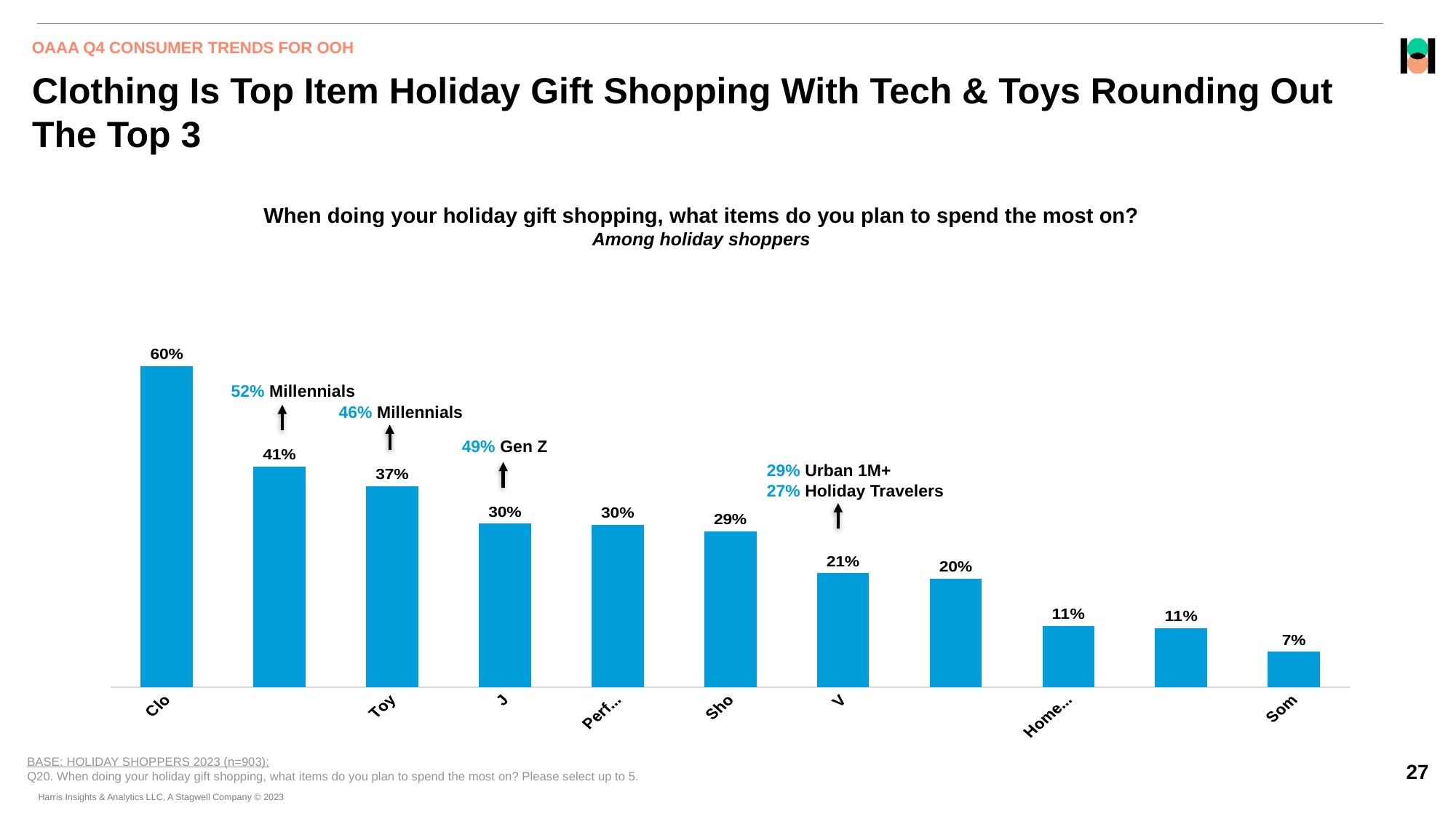
How many bars have a value of exactly 30%? 2 What is the difference between the first bar (60%) and the second bar (41%)? 19 percentage points What Gen Z percentage is annotated above the bar with 30% (labeled "J")? 49% What kind of chart is shown on the slide? bar chart What is the highest value shown in the chart? 60% What is the value of the bar labeled "Toy"? 37% How many bars are plotted in the chart? 11 Which is larger, the second bar or the third bar? the second bar (41%) What is the lowest value shown in the chart? 7% Do the bar values rise or fall from left to right across the chart? fall What is the value of the bar labeled "Home..."? 11% What is the value of the leftmost bar (labeled "Clo")? 60%